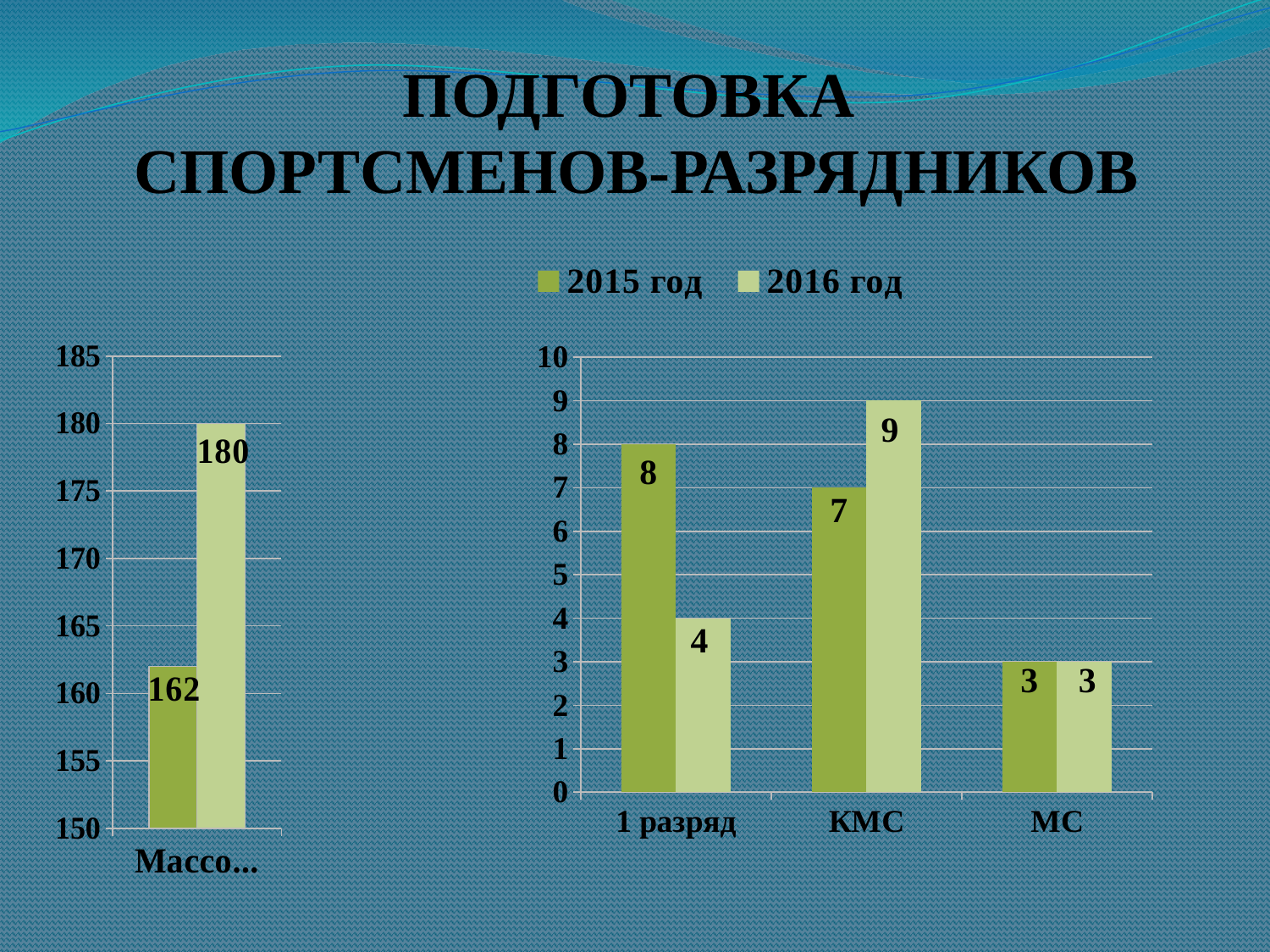
In the right chart, what is the value for 1 разряд in 2015 год? 8 In the right chart, what is the value for КМС in 2016 год? 9 In the left chart, what is the difference between the 2016 год and 2015 год values? 18 In the left chart, what is the value of the 2016 год bar? 180 How many categories are shown on the x axis of the right chart? 3 In the right chart, which category has the lowest value for 2015 год? МС In the right chart, which category has the highest value for 2016 год? КМС How many series does the legend list? 2 What kind of chart is the right chart? bar chart In the right chart, which is larger for КМС: the 2015 год value or the 2016 год value? 2016 год In the right chart, what is the difference between the 2015 год and 2016 год values for 1 разряд? 4 In the right chart, what is the value for МС in 2015 год? 3